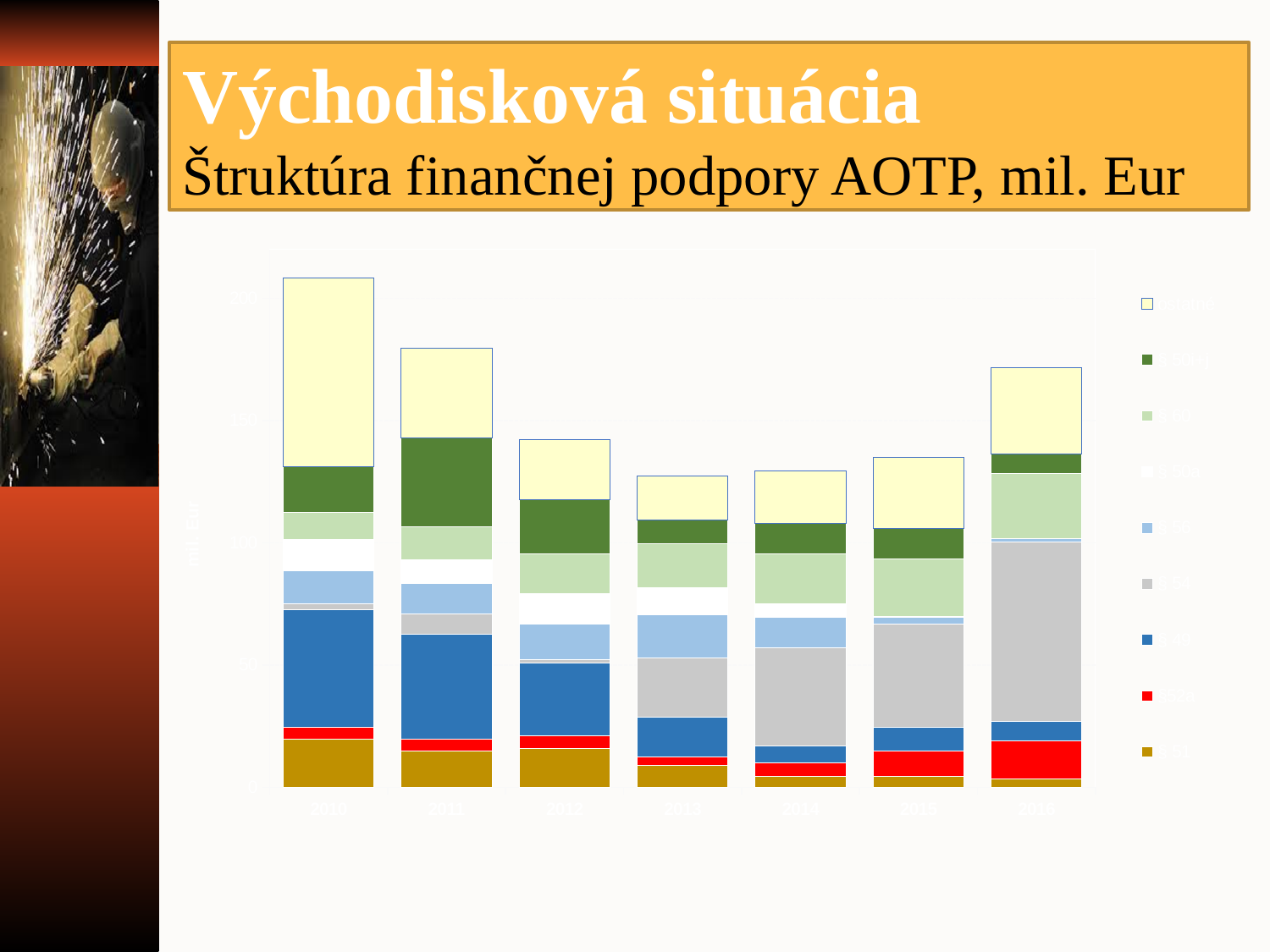
What unit is given in the slide subtitle for the chart values? mil. Eur Is the total for 2013 greater or less than 150? less Do the total bar heights rise or fall from 2010 to 2013? fall What kind of chart is shown on the slide? stacked bar chart Which total is larger, 2011 or 2012? 2011 How many series does the legend list? 9 How many bars (years) are plotted in the chart? 7 Is the total for 2010 greater or less than 200? greater Which year has the highest total bar? 2010 Which total is larger, 2010 or 2016? 2010 Is the total for 2011 greater or less than 200? less